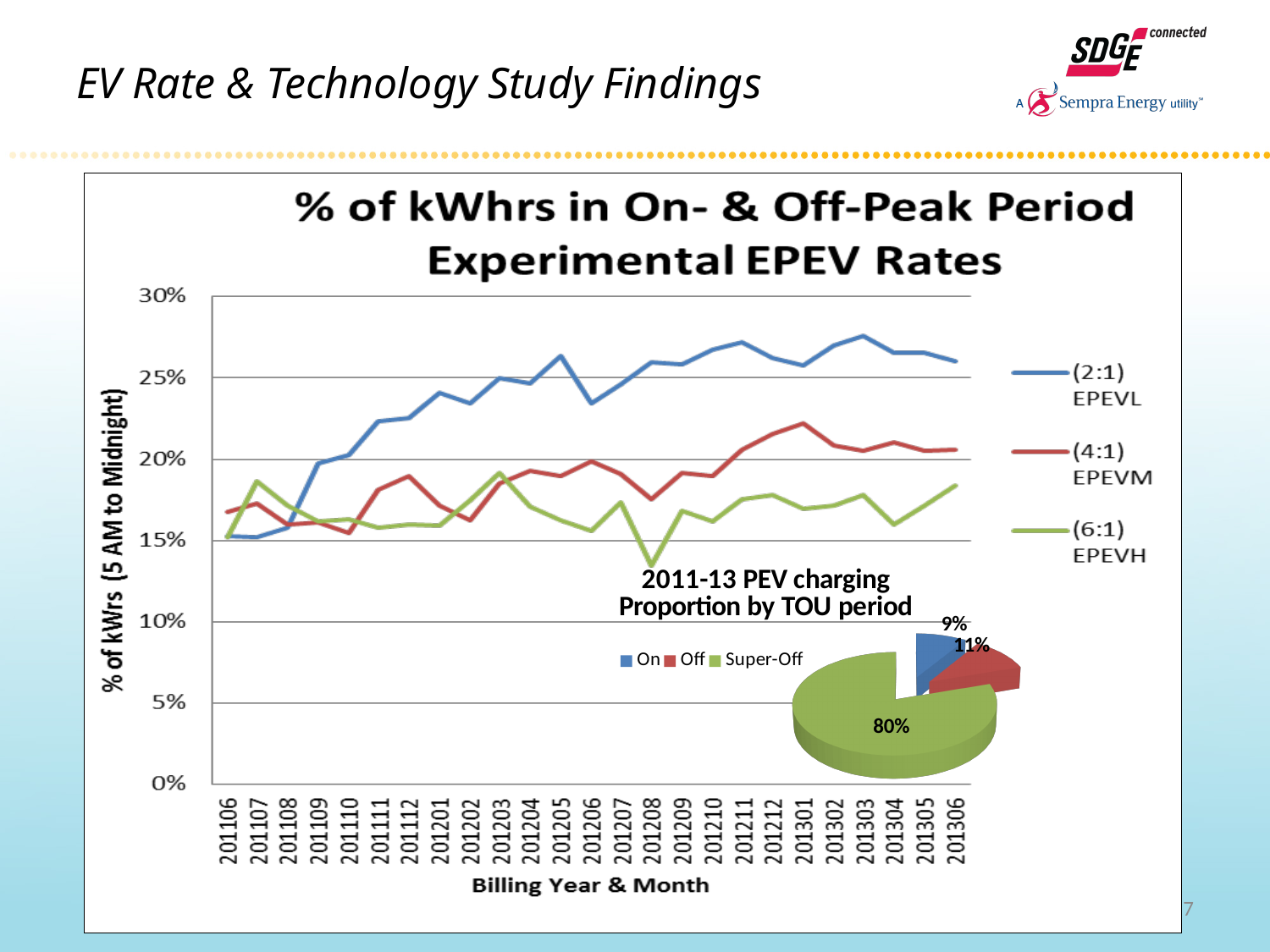
In the pie chart titled '2011-13 PEV charging Proportion by TOU period', what share is On? 9% In the pie chart titled '2011-13 PEV charging Proportion by TOU period', which slice is the largest? Super-Off How many billing months are shown on the x axis of the '% of kWhrs in On- & Off-Peak Period Experimental EPEV Rates' chart? 25 In the '% of kWhrs in On- & Off-Peak Period Experimental EPEV Rates' chart, does the (2:1) EPEVL series generally rise or fall from 201106 to 201306? rise In the '% of kWhrs in On- & Off-Peak Period Experimental EPEV Rates' chart, which series has the highest value at 201306? (2:1) EPEVL How many series does the legend of the '% of kWhrs in On- & Off-Peak Period Experimental EPEV Rates' chart list? 3 In the pie chart titled '2011-13 PEV charging Proportion by TOU period', how many percentage points larger is Off than On? 2% What kind of chart is the '% of kWhrs in On- & Off-Peak Period Experimental EPEV Rates' chart? line chart In the '% of kWhrs in On- & Off-Peak Period Experimental EPEV Rates' chart, is the value for (2:1) EPEVL at 201306 greater or less than 25%? greater In the pie chart titled '2011-13 PEV charging Proportion by TOU period', what share is Super-Off? 80% In the pie chart titled '2011-13 PEV charging Proportion by TOU period', what share is Off? 11% In the pie chart titled '2011-13 PEV charging Proportion by TOU period', which slice is the smallest? On